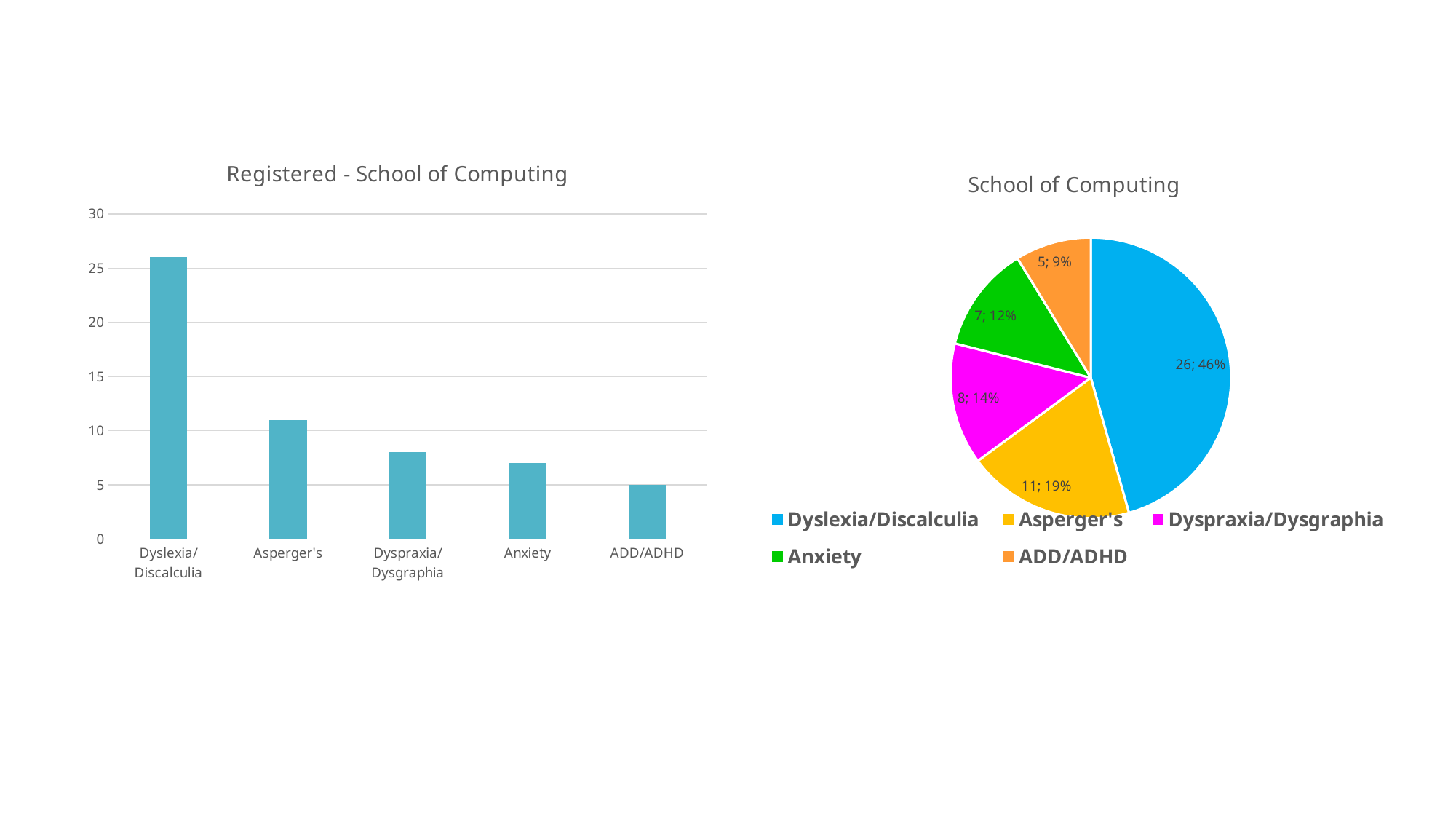
In the 'Registered - School of Computing' bar chart, is the value for Asperger's greater or less than 15? less In the 'Registered - School of Computing' bar chart, which category has the lowest bar? ADD/ADHD In the 'School of Computing' pie chart, what value is shown for the Asperger's slice? 11; 19% In the 'School of Computing' pie chart, what is the difference between the Dyspraxia/Dysgraphia count and the ADD/ADHD count? 3 How many entries does the legend of the 'School of Computing' pie chart list? 5 How many categories are shown in the 'Registered - School of Computing' bar chart? 5 In the 'School of Computing' pie chart, what share of the pie does Dyslexia/Discalculia have? 46% In the 'Registered - School of Computing' bar chart, is the value for Dyslexia/Discalculia greater or less than 25? greater What kind of chart is the chart titled 'Registered - School of Computing'? bar chart In the 'Registered - School of Computing' bar chart, do the bar values rise or fall from left to right? fall What kind of chart is the chart titled 'School of Computing' on the right? pie chart In the 'Registered - School of Computing' bar chart, which category has the highest bar? Dyslexia/Discalculia